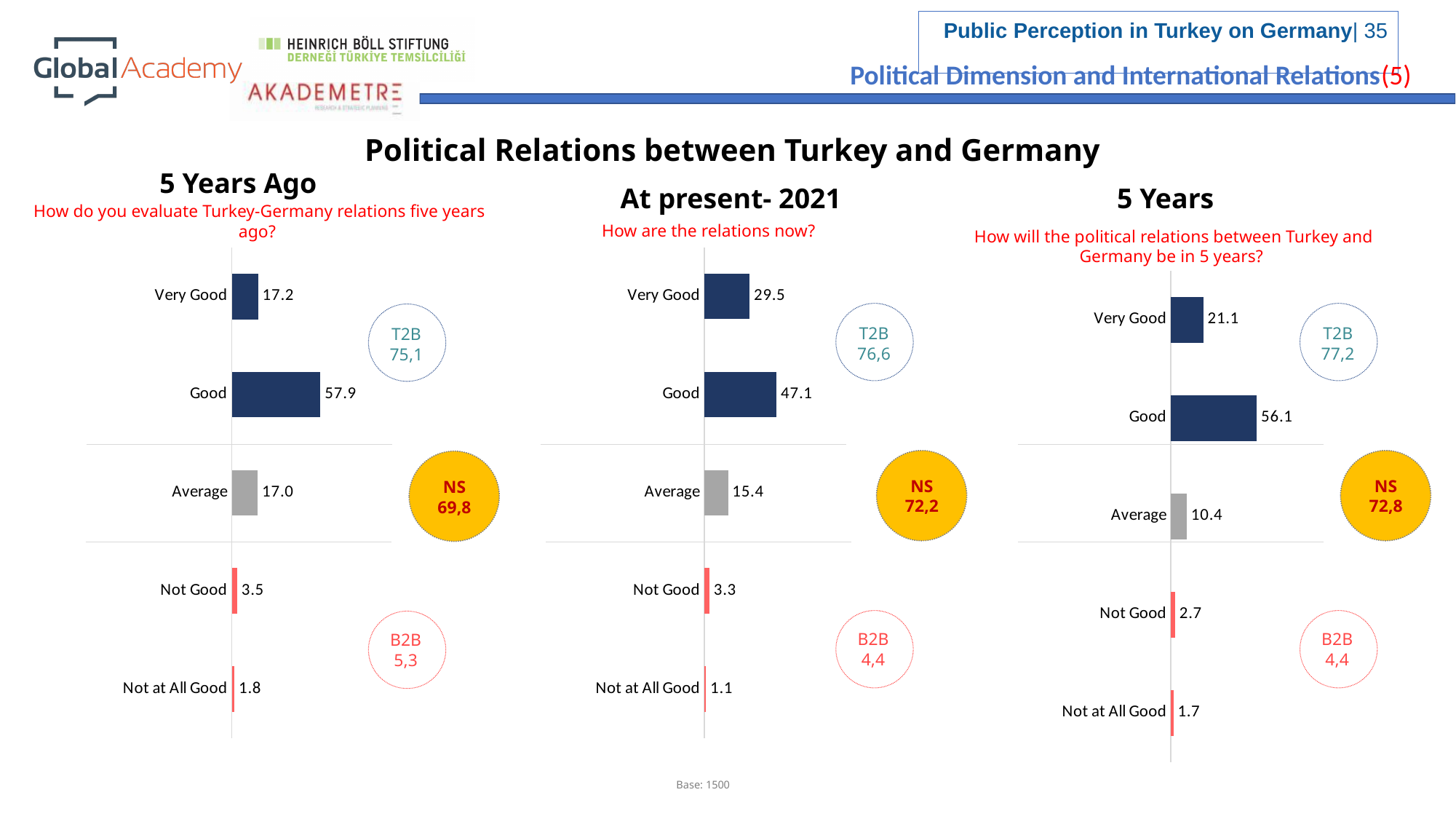
In the '5 Years Ago' chart, what is the value for Good? 57.9 In the '5 Years' chart, which category has the highest value? Good In the '5 Years' chart, what is the value for Average? 10.4 In the 'At present- 2021' chart, which category has the lowest value? Not at All Good In the '5 Years' chart, what is the value for Not Good? 2.7 In the 'At present- 2021' chart, what is the difference between the values for Average and Not Good? 12.1 What type of chart is the 'At present- 2021' chart? Bar chart How many categories are shown in the '5 Years Ago' chart? 5 Which is larger: the value for Very Good in the '5 Years Ago' chart or the value for Very Good in the '5 Years' chart? 5 Years In the 'At present- 2021' chart, what is the value for Very Good? 29.5 What is the T2B value shown next to the 'At present- 2021' chart? 76,6 In the '5 Years Ago' chart, what is the difference between the values for Good and Very Good? 40.7